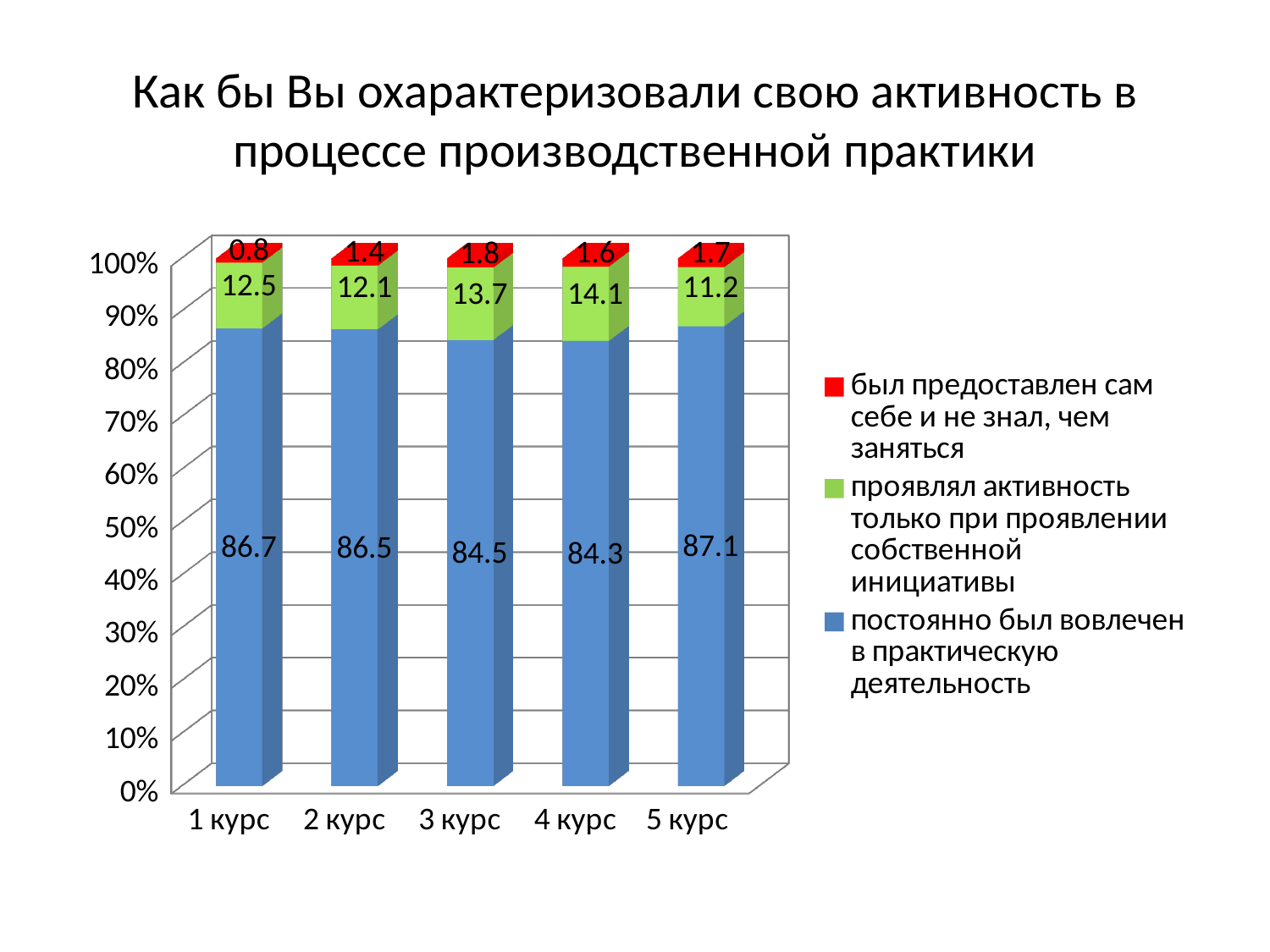
How many courses (categories) are shown on the x axis? 5 What value is shown for "постоянно был вовлечен в практическую деятельность" for 3 курс? 84.5 What is the difference between the "постоянно был вовлечен в практическую деятельность" values for 5 курс and 4 курс? 2.8 How many series does the legend list? 3 Which course has the highest value for "постоянно был вовлечен в практическую деятельность"? 5 курс Which colour represents "был предоставлен сам себе и не знал, чем заняться" in the legend? Red What kind of chart is shown on the slide? Stacked bar chart Which course has the lowest value for "проявлял активность только при проявлении собственной инициативы"? 5 курс Which course has the lowest value for "был предоставлен сам себе и не знал, чем заняться"? 1 курс What value is shown for "проявлял активность только при проявлении собственной инициативы" for 4 курс? 14.1 Which is larger: the "проявлял активность только при проявлении собственной инициативы" value for 3 курс or for 2 курс? 3 курс What value is shown for "был предоставлен сам себе и не знал, чем заняться" for 1 курс? 0.8